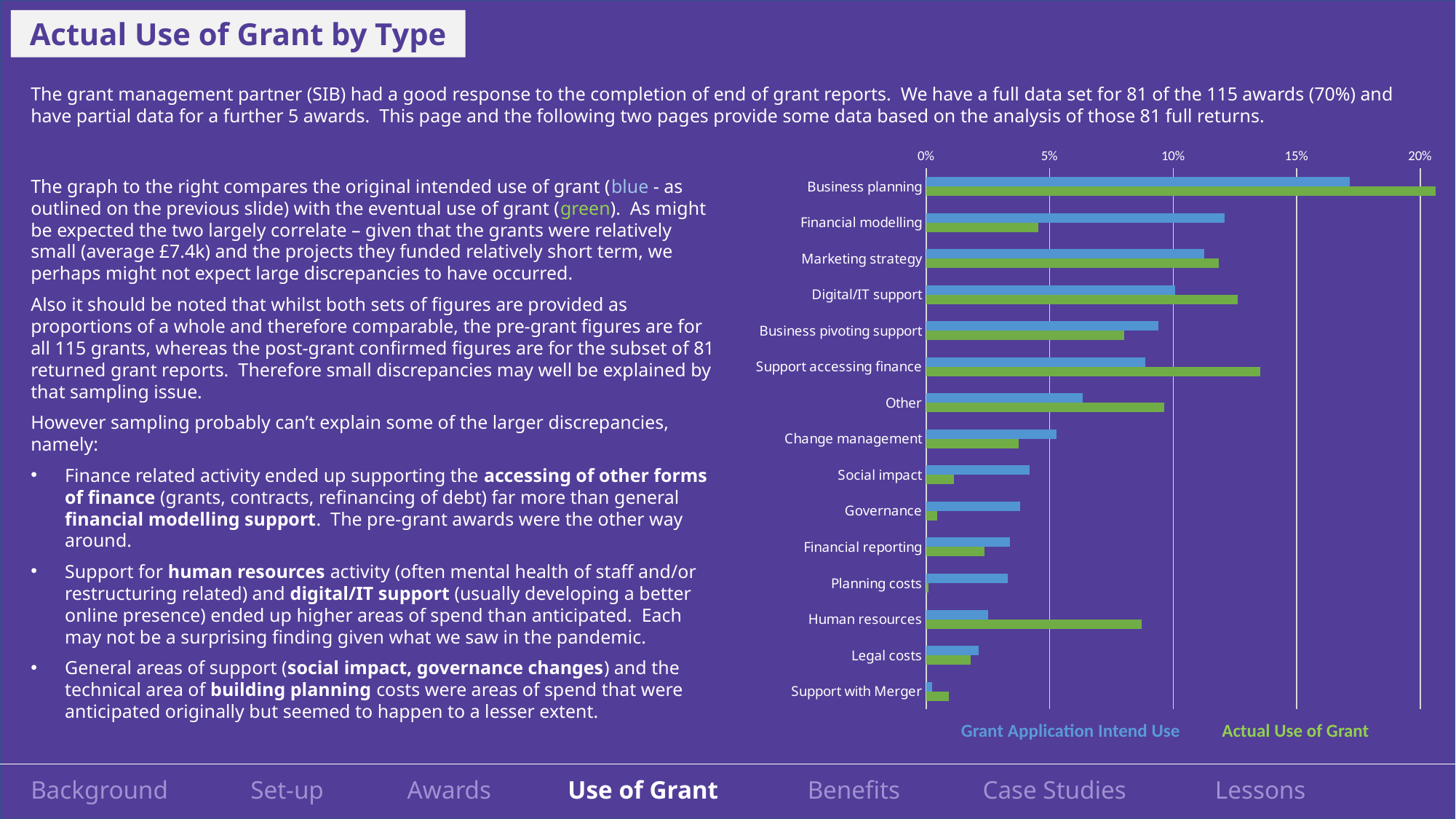
How many series does the chart's legend list? 2 Is the Actual Use of Grant value for Human resources greater or less than 5%? greater What kind of chart is shown on the slide? Bar chart How many grant-use categories are plotted on the chart? 15 Is the Actual Use of Grant value for Change management greater or less than 5%? less For Financial modelling, which is larger: Grant Application Intend Use or Actual Use of Grant? Grant Application Intend Use Which category has the highest Actual Use of Grant value? Business planning Which colour represents the Actual Use of Grant series? Green Which category has the lowest Grant Application Intend Use value? Support with Merger Is the Grant Application Intend Use value for Business planning greater or less than 15%? greater For Human resources, which is larger: Grant Application Intend Use or Actual Use of Grant? Actual Use of Grant